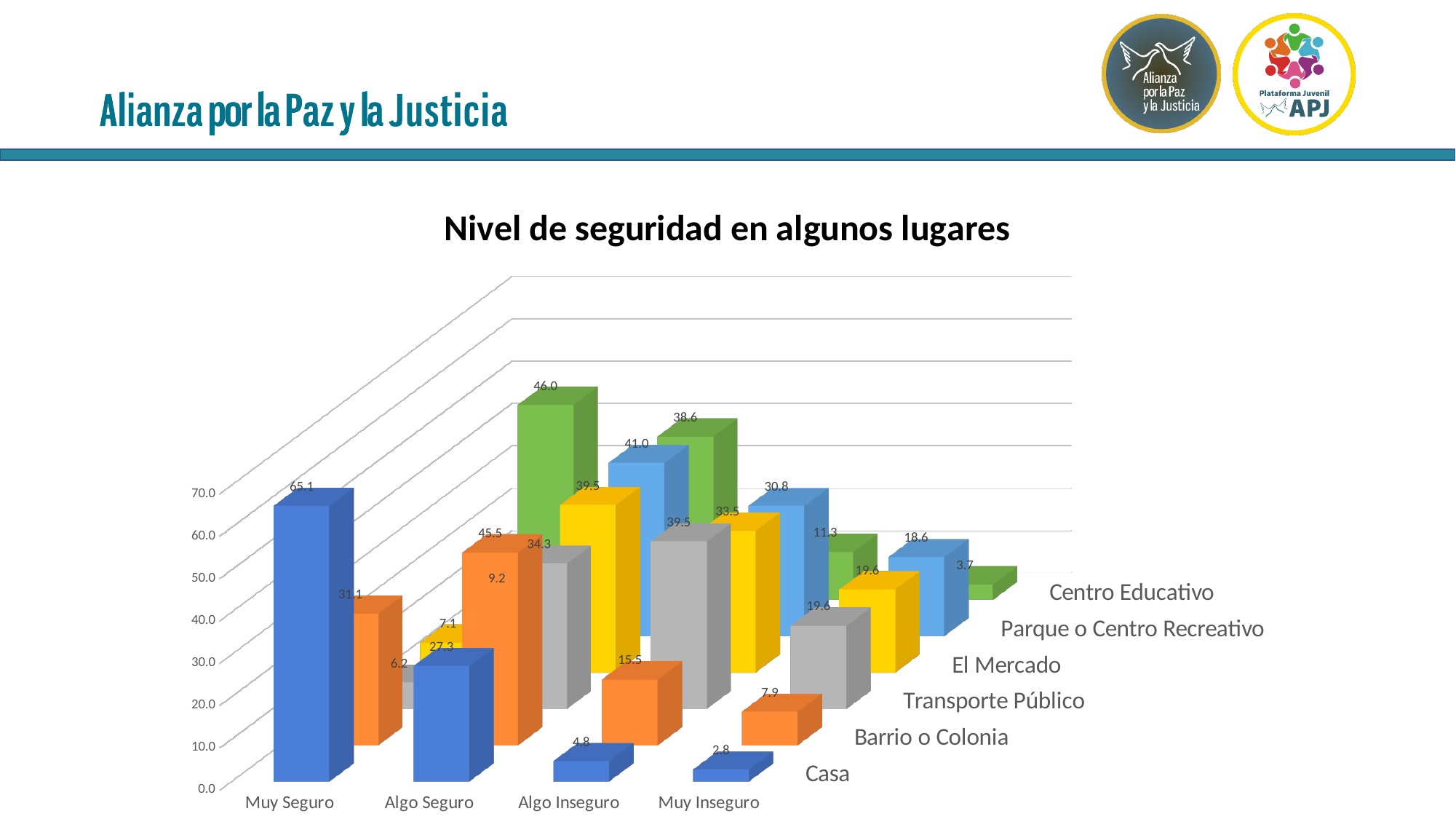
In the Muy Seguro category, which is larger: Casa or Barrio o Colonia? Casa Which category has the lowest value for Casa? Muy Inseguro How many categories are shown on the x axis? 4 What is the value for Centro Educativo in the Muy Seguro category? 46.0 What kind of chart is shown on the slide? Bar chart What is the difference between the Casa values for Muy Seguro and Algo Seguro? 37.8 Which category has the highest value for Casa? Muy Seguro What is the value for Casa in the Muy Seguro category? 65.1 How many series (places) does the chart show? 6 What is the value for Barrio o Colonia in the Algo Seguro category? 45.5 What is the value for Centro Educativo in the Muy Inseguro category? 3.7 What is the value for Casa in the Muy Inseguro category? 2.8